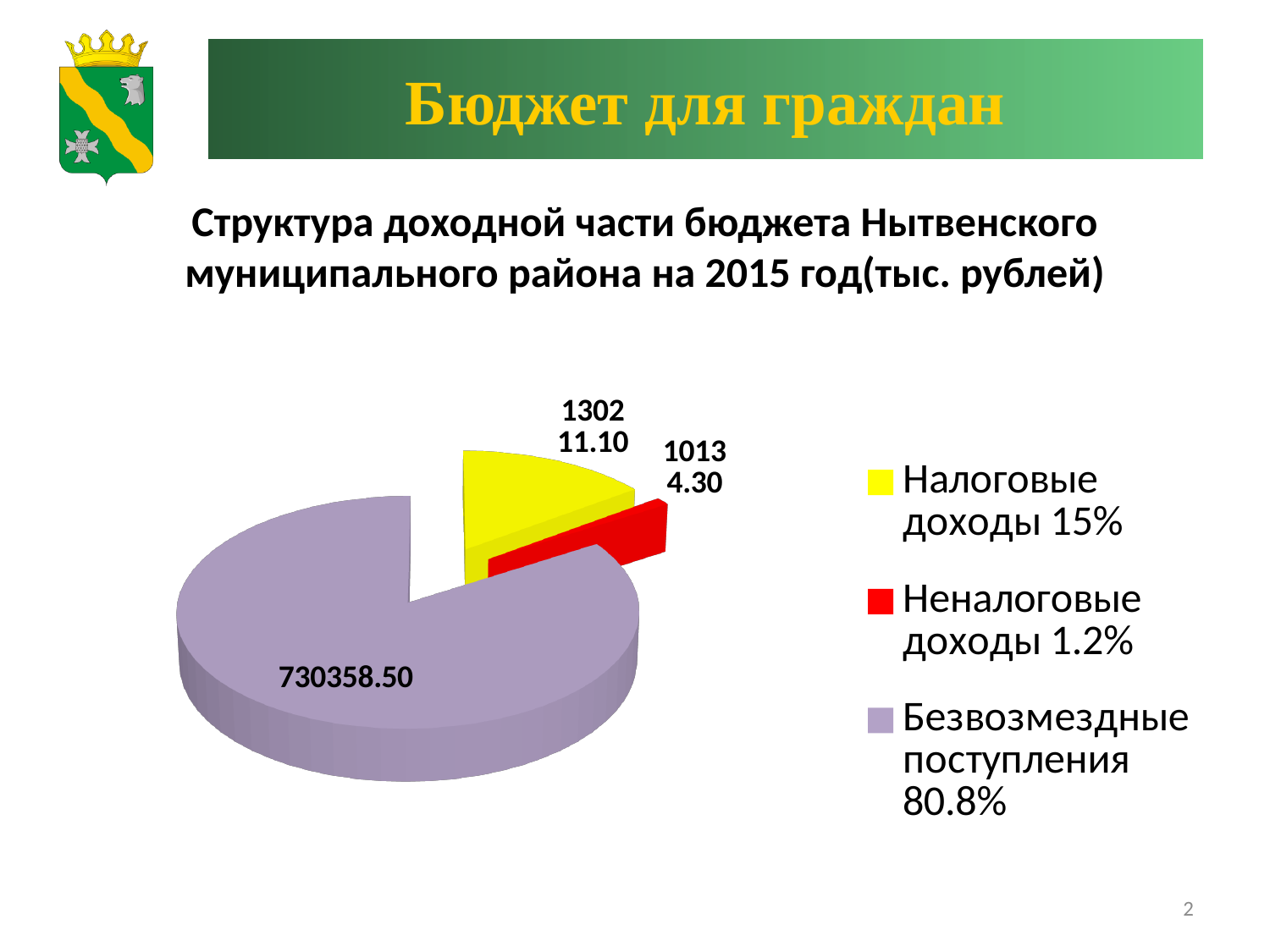
What share of the pie does Безвозмездные поступления represent, according to the legend? 80.8% Which category has the smallest slice in the pie chart? Неналоговые доходы Which category has the largest slice in the pie chart? Безвозмездные поступления What value is printed on the Безвозмездные поступления slice of the pie chart? 730358.50 Which slice is larger in the pie chart: Налоговые доходы or Неналоговые доходы? Налоговые доходы What share of the pie does Налоговые доходы represent, according to the legend? 15% What is the title of the chart on the slide? Структура доходной части бюджета Нытвенского муниципального района на 2015 год(тыс. рублей) How many entries does the legend of the pie chart list? 3 What type of chart is shown on the slide? pie chart How many slices does the pie chart have? 3 What share of the pie does Неналоговые доходы represent, according to the legend? 1.2% What colour is the Неналоговые доходы slice in the pie chart? red